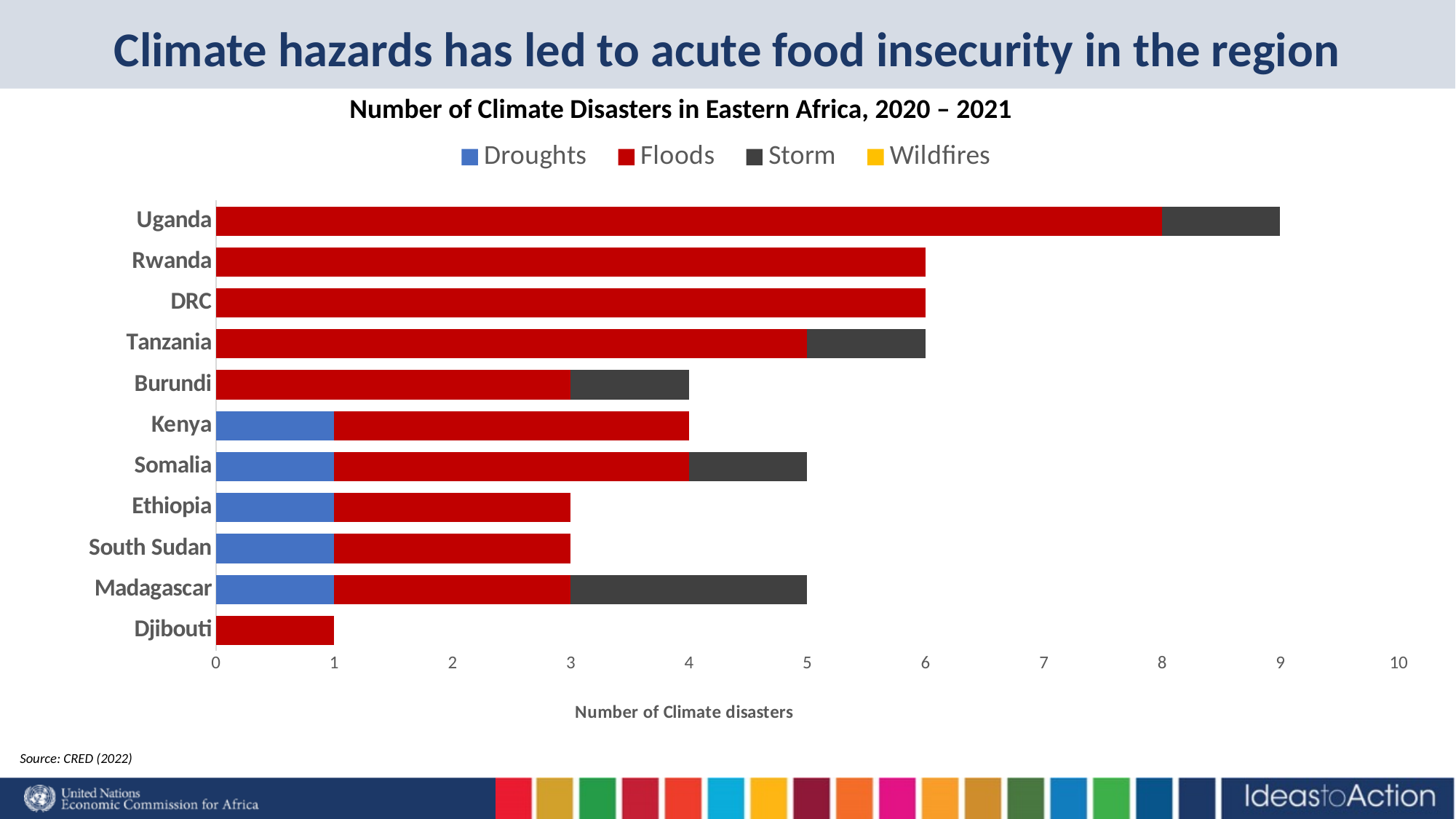
What kind of chart is shown on the slide? Stacked bar chart What is the total number of climate disasters for Uganda? 9 Which country has the lowest total number of climate disasters? Djibouti How many countries are shown on the chart? 11 Which country has the highest total number of climate disasters? Uganda What is the title of the chart? Number of Climate Disasters in Eastern Africa, 2020 – 2021 Which has a larger total number of climate disasters, Madagascar or Ethiopia? Madagascar How many floods are shown for Uganda? 8 How many series does the legend list? 4 What is the difference between the total number of climate disasters for Uganda and for Tanzania? 3 What is the total number of climate disasters for Somalia? 5 How many floods are shown for Rwanda? 6